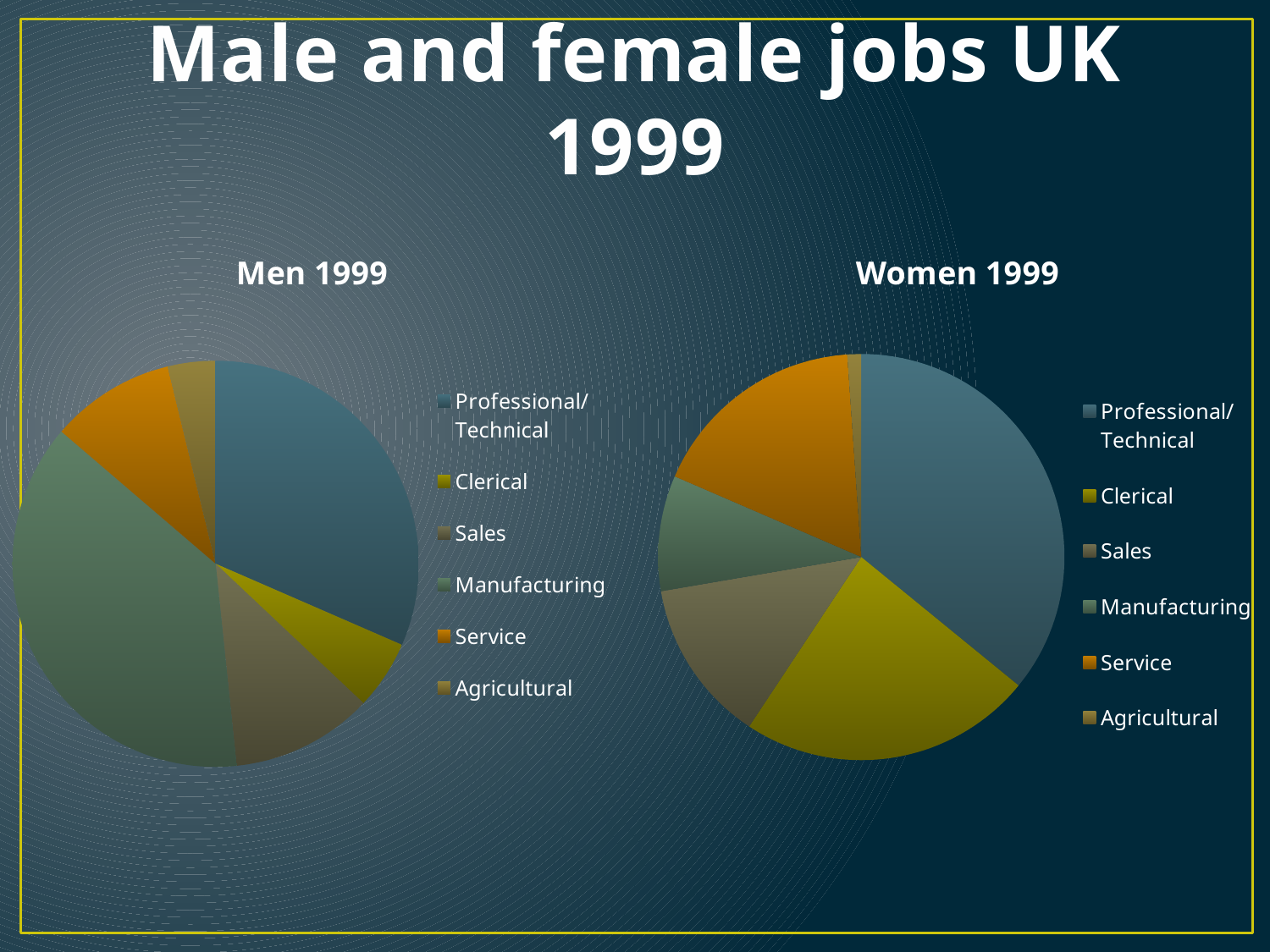
How many slices does the Women 1999 pie chart have? 6 How many categories does the legend of the Men 1999 chart list? 6 What is the title of the slide containing the two pie charts? Male and female jobs UK 1999 In the Women 1999 chart, which category has the largest slice? Professional/Technical What kind of chart is the Men 1999 chart? pie chart In the Women 1999 chart, which category has the smallest slice? Agricultural In the Men 1999 chart, which category has the smallest slice? Agricultural In the Men 1999 chart, which slice is larger, Professional/Technical or Clerical? Professional/Technical What kind of chart is the Women 1999 chart? pie chart In the Women 1999 chart, which slice is larger, Clerical or Sales? Clerical In the Men 1999 chart, which slice is larger, Manufacturing or Service? Manufacturing